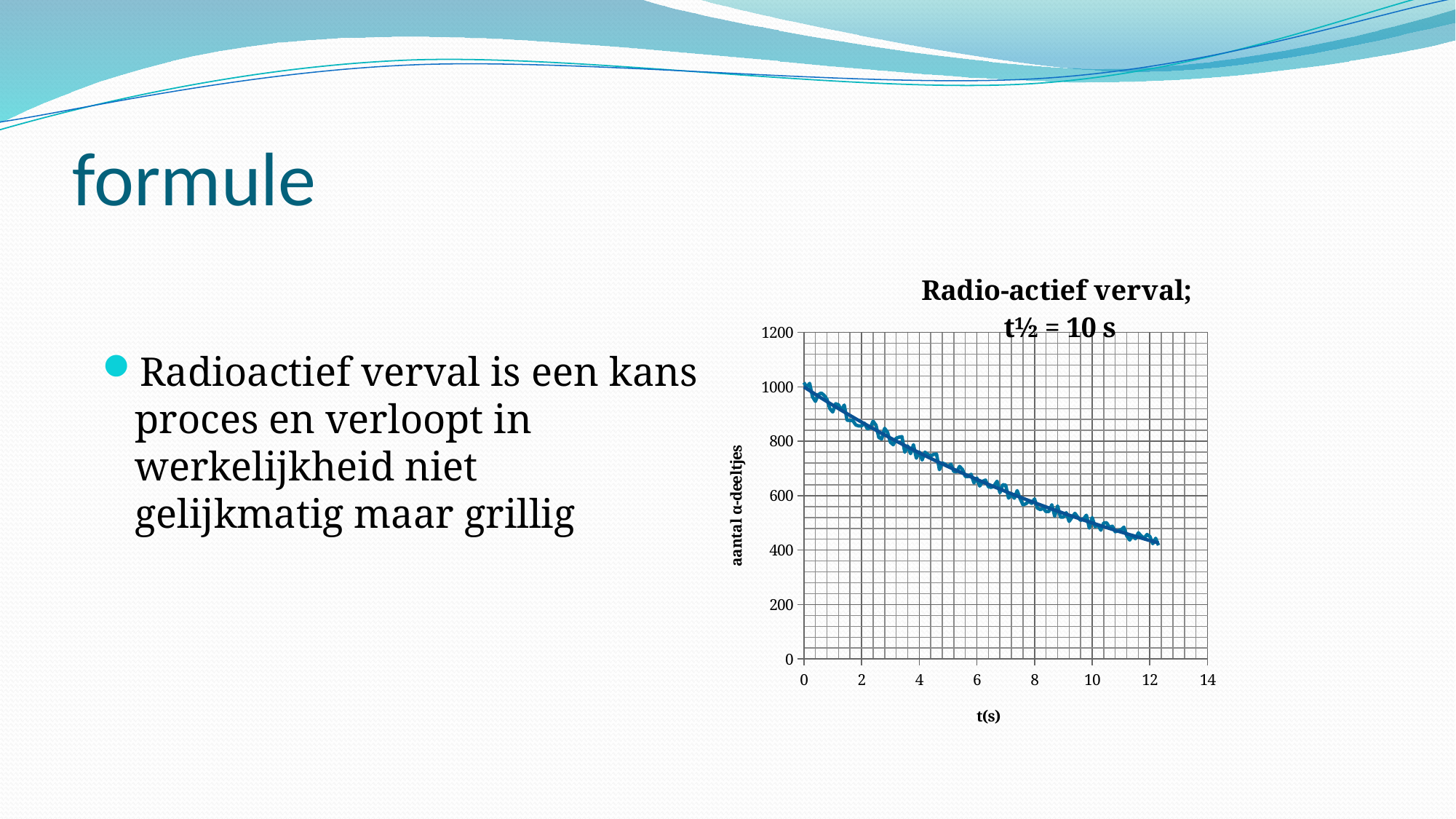
Is the value at t = 10 s greater or less than 600? less At which value of t(s) is the number of α-deeltjes highest? 0 Is the value at t = 0 s larger or smaller than the value at t = 12 s? larger What is the title of the chart? Radio-actief verval; t½ = 10 s What is the label of the y axis of the chart? aantal α-deeltjes Is the value at t = 12 s greater or less than 600? less What kind of chart is shown on the slide? line chart Is the value at t = 2 s greater or less than 800? greater Do the values in the chart rise or fall as t(s) increases? fall